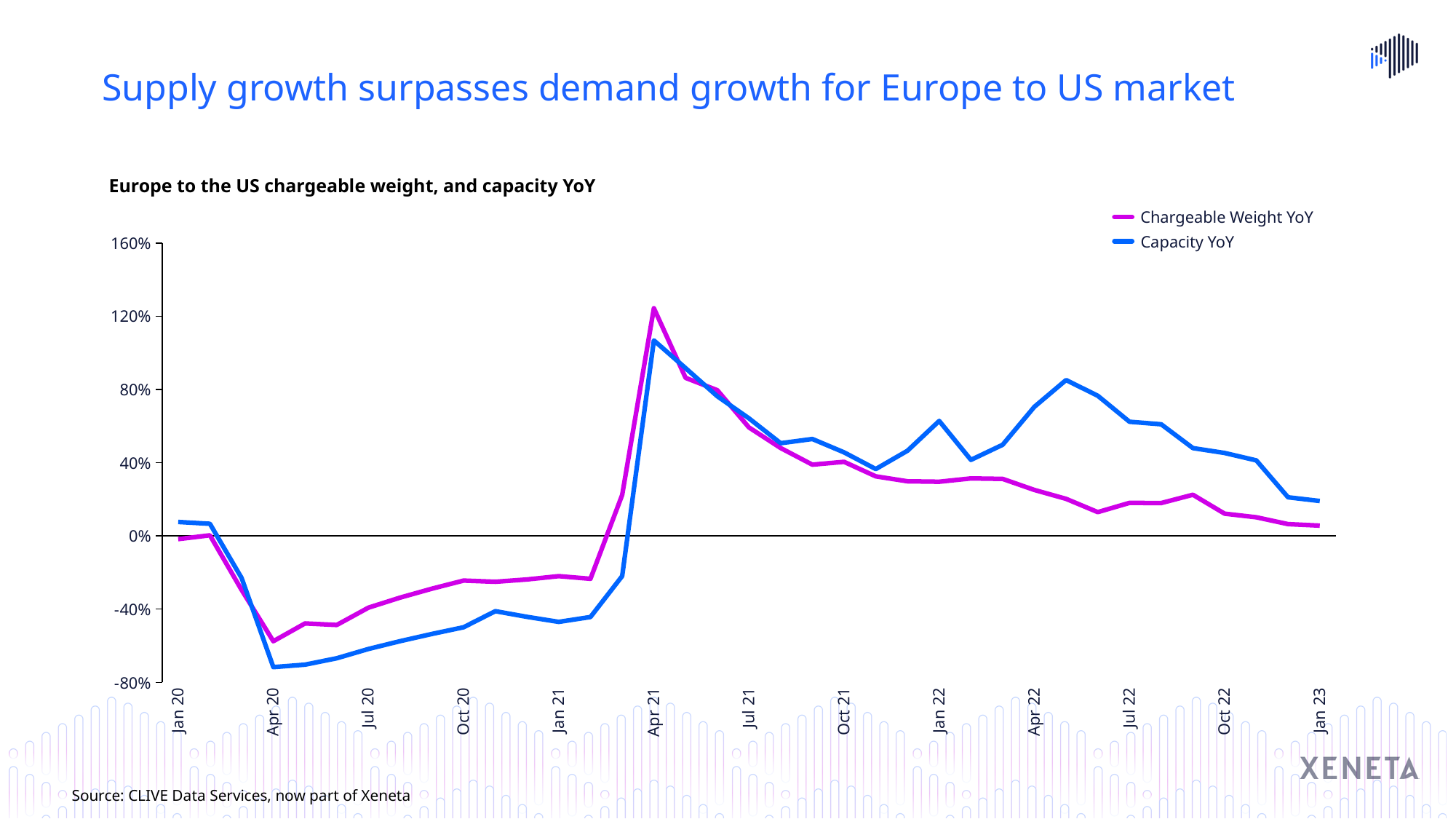
At Apr 20, which series has the higher value, Chargeable Weight YoY or Capacity YoY? Chargeable Weight YoY From Apr 21 to Jan 23, does Chargeable Weight YoY generally rise or fall? fall What are the two series named in the legend? Chargeable Weight YoY and Capacity YoY What is the title of the chart? Europe to the US chargeable weight, and capacity YoY At Jan 23, which series has the higher value, Chargeable Weight YoY or Capacity YoY? Capacity YoY What kind of chart is shown on the slide? line chart Is the value for Capacity YoY at Apr 20 greater or less than -40%? less At Apr 21, which series has the higher value, Chargeable Weight YoY or Capacity YoY? Chargeable Weight YoY In which month does Chargeable Weight YoY reach its highest value? Apr 21 Is the value for Chargeable Weight YoY at Apr 21 greater or less than 80%? greater Is the value for Capacity YoY at Jan 23 greater or less than 40%? less How many series does the legend list? 2